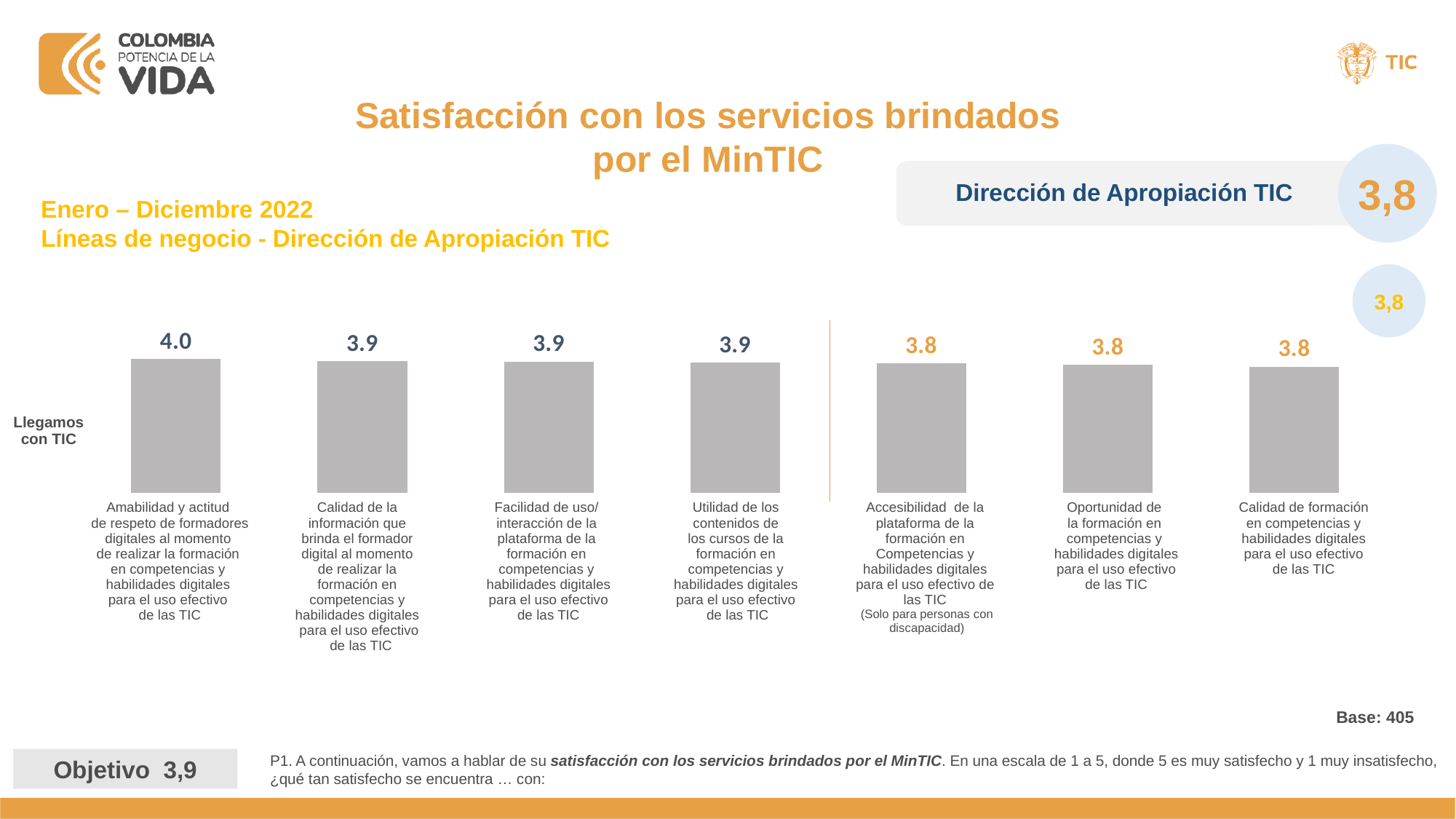
How many categories (bars) are shown in the chart? 7 What is the overall score shown for Dirección de Apropiación TIC? 3,8 What is the satisfaction value for "Amabilidad y actitud de respeto de formadores digitales"? 4.0 Which is larger: the value for "Utilidad de los contenidos de los cursos" or the value for "Calidad de formación en competencias y habilidades digitales"? Utilidad de los contenidos de los cursos What is the value shown for "Calidad de la información que brinda el formador digital"? 3.9 Do the values rise or fall from left to right across the chart? Fall What is the difference between the value for "Amabilidad y actitud de respeto de formadores digitales" and the value for "Calidad de formación en competencias y habilidades digitales"? 0.2 What is the base (number of respondents) shown on the slide? 405 What kind of chart is shown on the slide? Bar chart Which category has the highest satisfaction value? Amabilidad y actitud de respeto de formadores digitales What is the value shown for "Accesibilidad de la plataforma de la formación en Competencias y habilidades digitales"? 3.8 What is the value shown for "Oportunidad de la formación en competencias y habilidades digitales"? 3.8